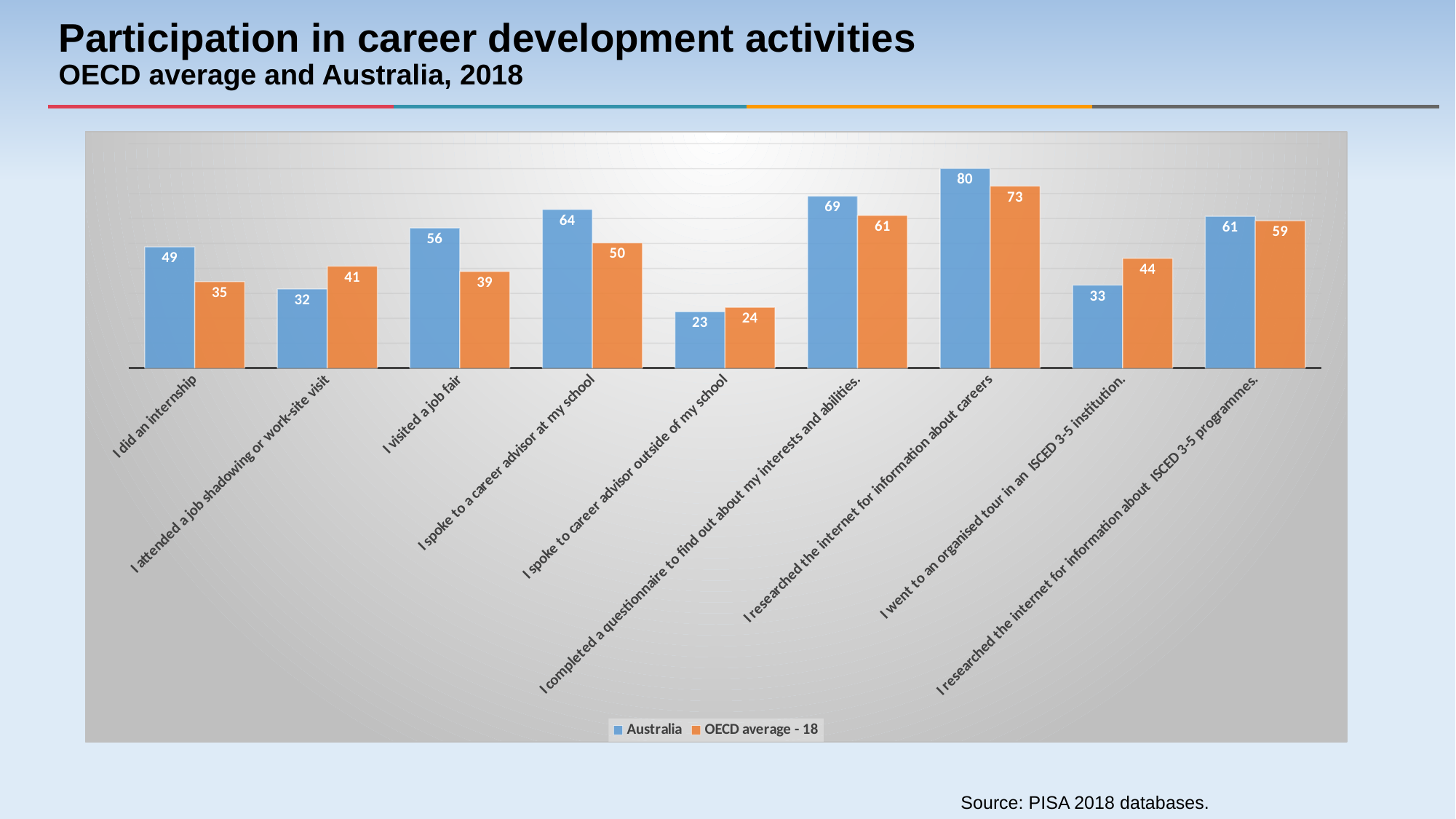
Which category has the lowest OECD average - 18 value? I spoke to career advisor outside of my school What is the Australia value for 'I researched the internet for information about careers'? 80 Which colour represents the Australia series? Blue Which category has the highest Australia value? I researched the internet for information about careers What is the difference between the Australia and OECD average - 18 values for 'I spoke to a career advisor at my school'? 14 How many series does the legend list? 2 How many categories are shown on the x axis? 9 For 'I attended a job shadowing or work-site visit', which is larger: Australia or OECD average - 18? OECD average - 18 For 'I went to an organised tour in an ISCED 3-5 institution', which is larger: Australia or OECD average - 18? OECD average - 18 What is the Australia value for 'I did an internship'? 49 What kind of chart is shown on the slide? Bar chart What is the OECD average - 18 value for 'I visited a job fair'? 39